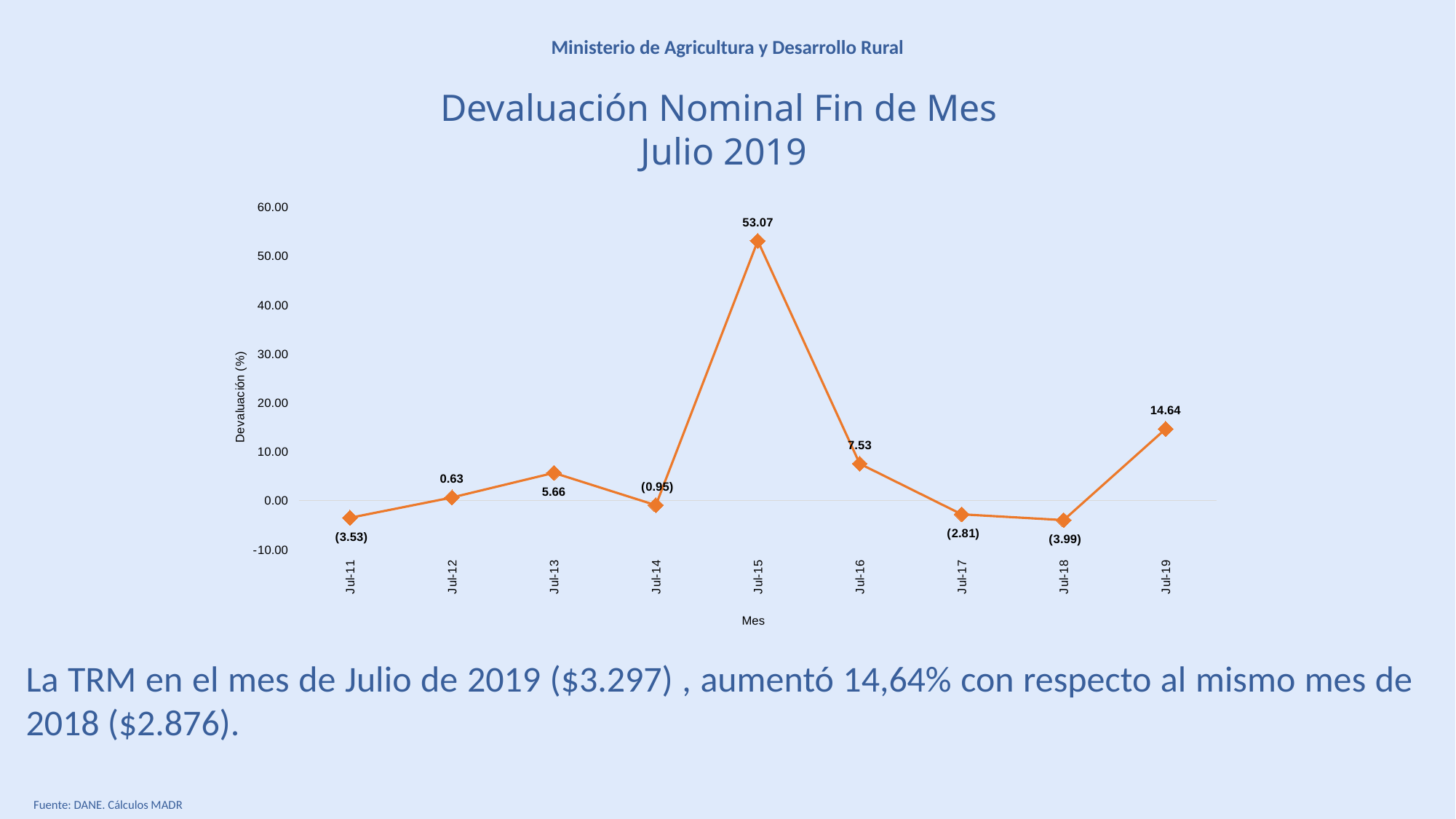
Is the value for Jul-15 greater or less than 50.00? greater What is the value for Jul-11? (3.53) What is the difference between the values for Jul-15 and Jul-16? 45.54 What kind of chart is shown? line chart What is the label of the vertical axis? Devaluación (%) What is the value for Jul-15? 53.07 How many months are plotted on the chart? 9 Which is larger, the value for Jul-13 or the value for Jul-12? Jul-13 What is the value for Jul-16? 7.53 Which month has the highest value? Jul-15 What is the value for Jul-19? 14.64 Which month has the lowest value? Jul-18